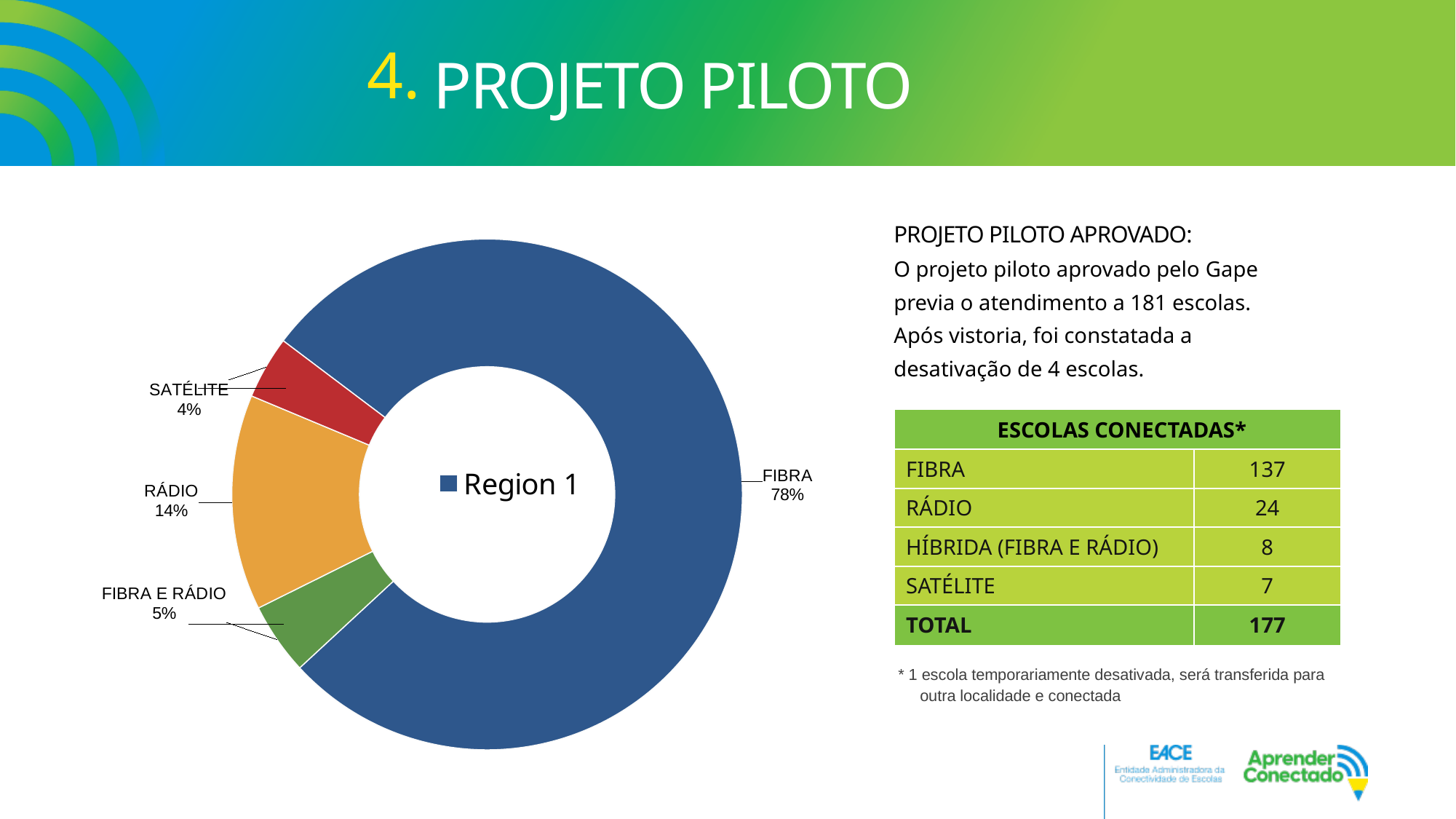
Which has a larger share in the chart, RÁDIO or SATÉLITE? RÁDIO What percentage share does FIBRA E RÁDIO have in the chart? 5% What percentage share does FIBRA have in the chart? 78% Which category has the largest share in the chart? FIBRA How many categories are shown in the chart? 4 What legend entry is shown in the centre of the chart? Region 1 What colour is the FIBRA slice in the chart? Blue What percentage share does RÁDIO have in the chart? 14% Which category has the smallest share in the chart? SATÉLITE What percentage share does SATÉLITE have in the chart? 4% What is the difference in percentage points between the FIBRA share and the RÁDIO share? 64 What kind of chart is shown on the slide? Doughnut chart